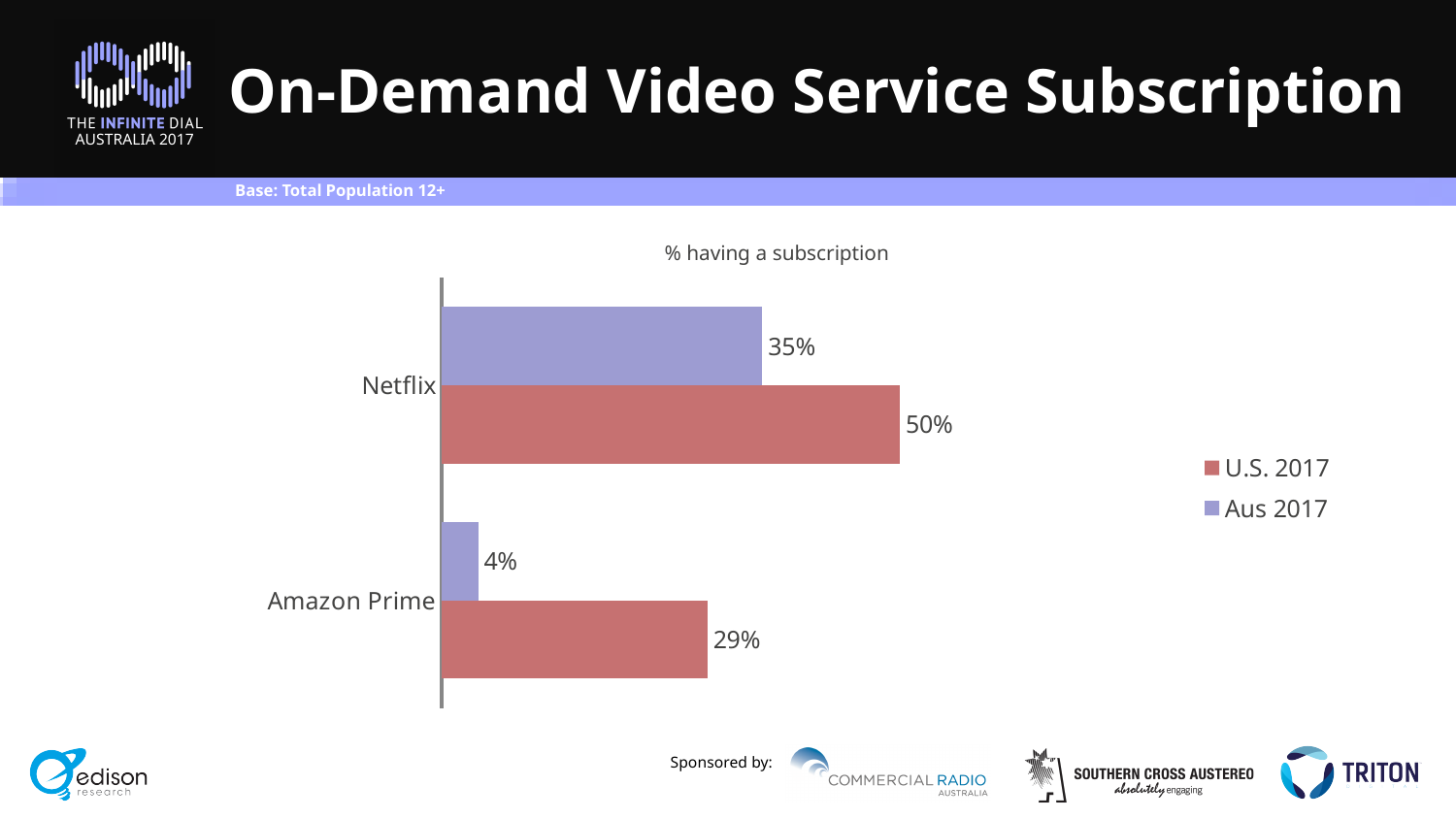
Which service has the lowest subscription percentage for Aus 2017? Amazon Prime What is the difference between the U.S. 2017 and Aus 2017 values for Amazon Prime? 25% What percentage of the Aus 2017 population has a Netflix subscription? 35% What percentage of the U.S. 2017 population has a Netflix subscription? 50% How many series does the legend list? 2 Which service has the highest subscription percentage for U.S. 2017? Netflix What is the difference between the U.S. 2017 and Aus 2017 values for Netflix? 15% What is the U.S. 2017 value for Amazon Prime? 29% What kind of chart is shown on the slide? Bar chart How many services are shown on the chart? 2 Which is larger for Amazon Prime: the U.S. 2017 value or the Aus 2017 value? U.S. 2017 What is the Aus 2017 value for Amazon Prime? 4%